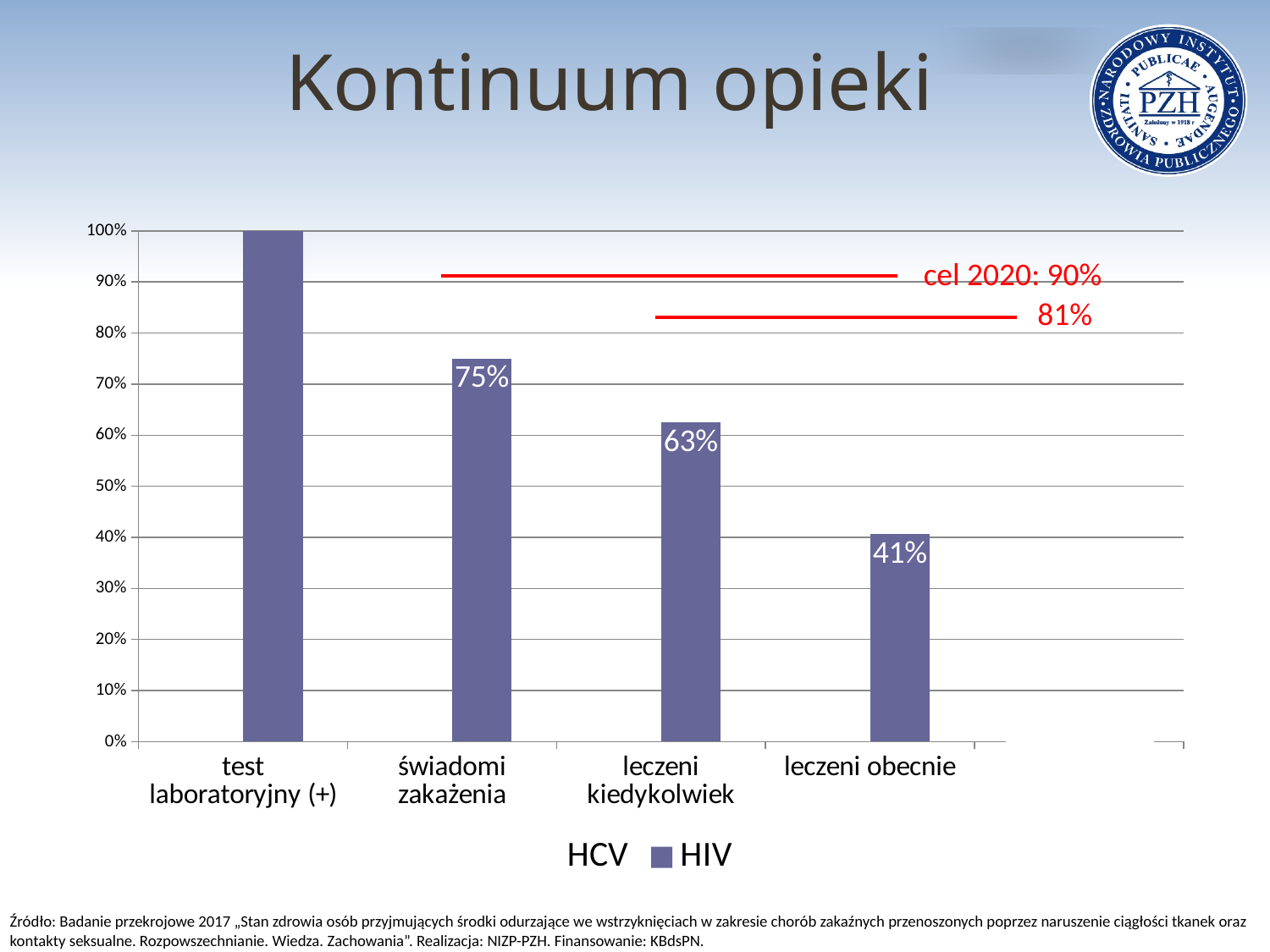
Which category has the highest bar? test laboratoryjny (+) Is the value for 'test laboratoryjny (+)' greater or less than 90%? greater What is the difference between the values for 'świadomi zakażenia' and 'leczeni obecnie'? 34% What is the value for 'leczeni obecnie'? 41% Which is larger, the value for 'leczeni kiedykolwiek' or the value for 'leczeni obecnie'? leczeni kiedykolwiek What kind of chart is shown on the slide? bar chart What is the difference between the values for 'świadomi zakażenia' and 'leczeni kiedykolwiek'? 12% What is the value for 'leczeni kiedykolwiek'? 63% What is the value for 'świadomi zakażenia'? 75% How many categories are shown on the x axis? 4 Do the values rise or fall from left to right along the x axis? fall Which category has the lowest value? leczeni obecnie